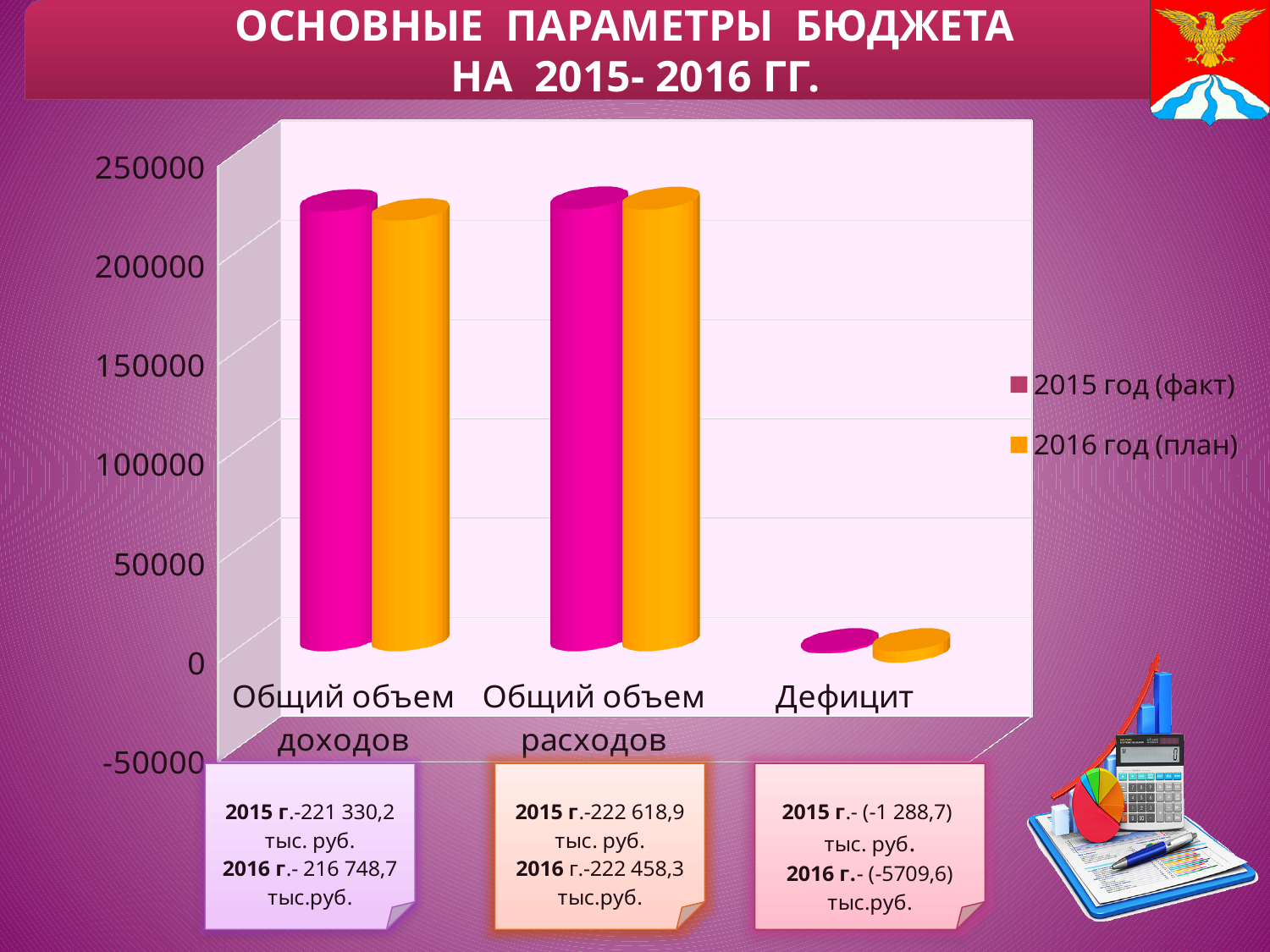
How many series does the chart legend list? 2 Is the 2016 год (план) value for Дефицит greater or less than 50000? less Which category has the lowest values in the chart? Дефицит Which is larger for Общий объем доходов: the 2015 год (факт) value or the 2016 год (план) value? 2015 год (факт) According to the note under the chart, what is the 2016 value for Общий объем расходов? 222 458,3 тыс.руб. According to the note under the chart, what is the 2016 value for Дефицит? (-5709,6) тыс.руб. What are the two series named in the chart legend? 2015 год (факт) and 2016 год (план) Using the values in the notes, what is the difference between the 2015 and 2016 values for Общий объем доходов? 4 581,5 тыс. руб. What kind of chart is shown on the slide? bar chart How many categories are shown on the x axis of the chart? 3 Is the 2015 год (факт) value for Общий объем доходов greater or less than 200000? greater According to the note under the chart, what is the 2015 value for Общий объем доходов? 221 330,2 тыс. руб.